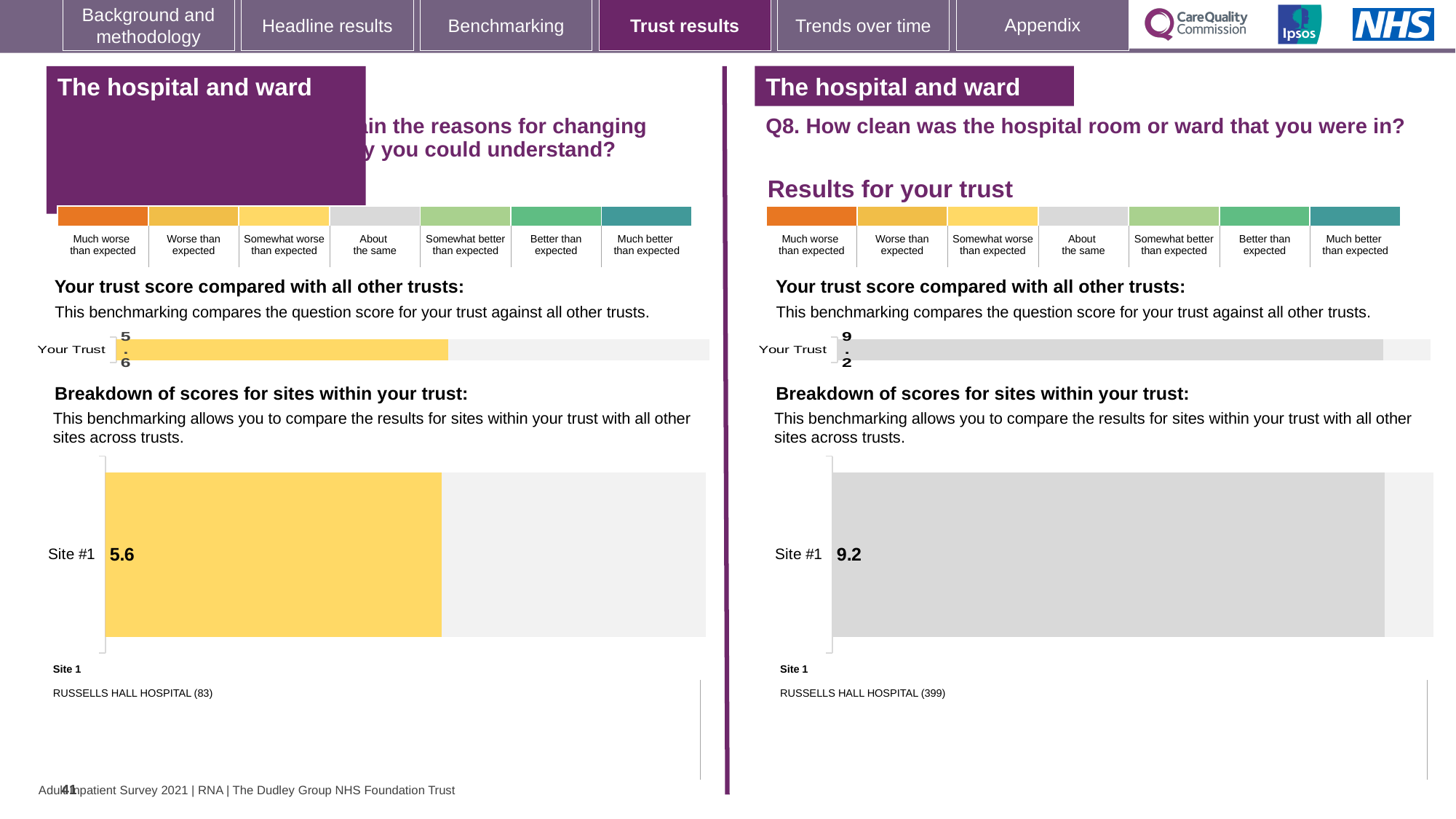
On the left-hand chart, which benchmark category does the yellow colour of the Site #1 bar correspond to? Somewhat worse than expected What is the difference between the Site #1 score on the right-hand chart for Q8 and the Site #1 score on the left-hand chart? 3.6 How many sites are shown in the breakdown of scores on the left-hand chart? 1 On the left-hand chart, what is the score shown for Site #1? 5.6 On the left-hand chart, what is the score shown for Your Trust? 5.6 On the right-hand chart for Q8, what is the score shown for Site #1? 9.2 Which is larger: the Site #1 score on the left-hand chart or the Site #1 score on the right-hand chart for Q8? Site #1 on the right-hand chart (Q8) What kind of chart is used to show the Site #1 score on the right-hand side for Q8? Bar chart How many sites are shown in the breakdown of scores on the right-hand chart for Q8? 1 On the right-hand chart for Q8 (how clean was the hospital room or ward), what is the score shown for Your Trust? 9.2 Which site name is listed as Site 1 on the right-hand chart for Q8? RUSSELLS HALL HOSPITAL (399) On the right-hand chart for Q8, which benchmark category does the grey colour of the Site #1 bar correspond to? About the same